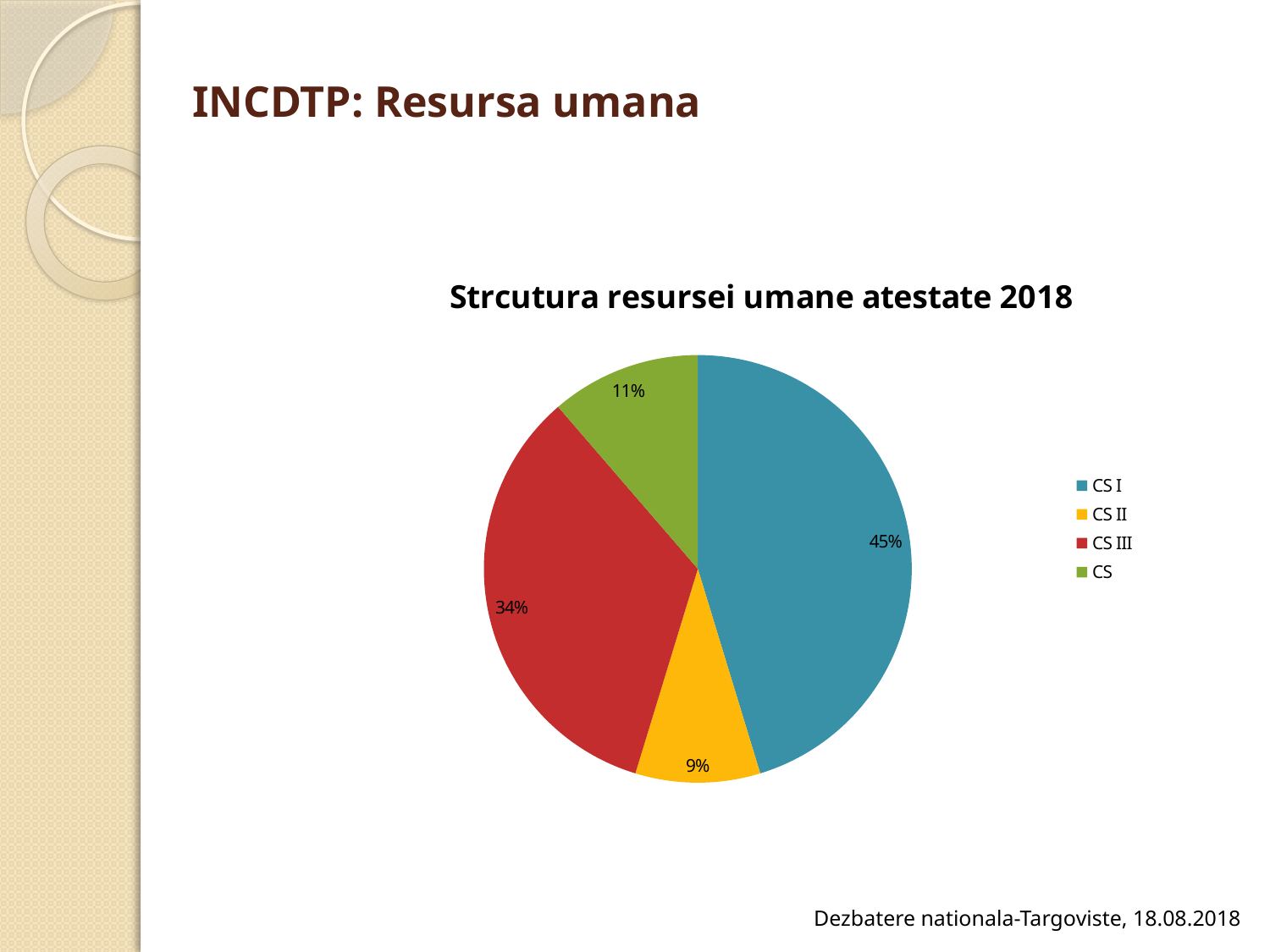
How many categories does the pie chart have? 4 What share of the pie does CS represent? 11% What colour is the slice for CS III? red What is the title of the chart? Strcutura resursei umane atestate 2018 What share of the pie does CS I represent? 45% Which has a larger share, CS II or CS? CS Which category has the smallest share of the pie? CS II What type of chart is shown on the slide? pie chart What is the difference in percentage points between the shares of CS I and CS III? 11 What share of the pie does CS III represent? 34% Which category has the largest share of the pie? CS I